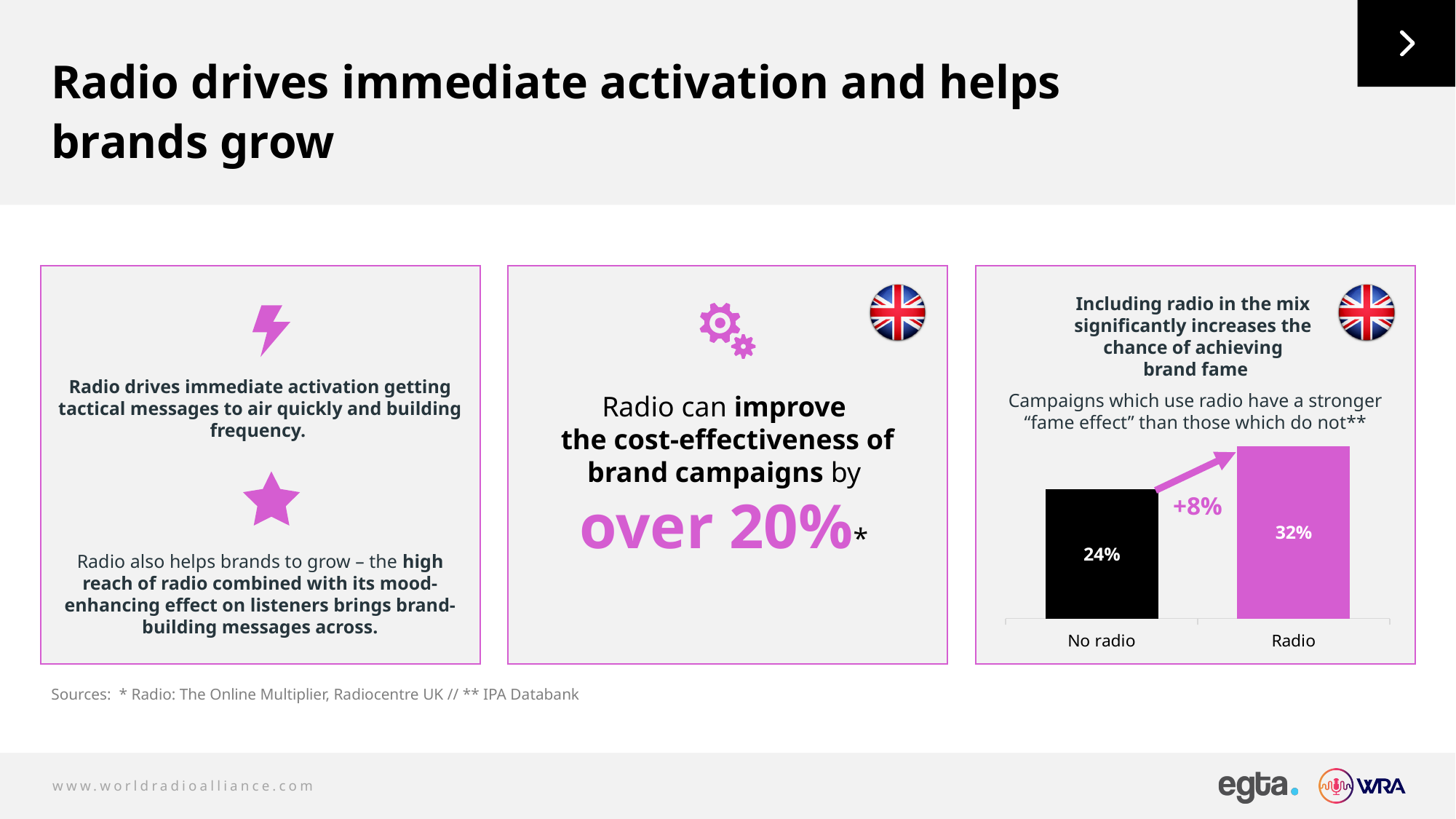
Which category has the higher value in the bar chart? Radio What is the value for No radio in the bar chart? 24% Do the values rise or fall from No radio to Radio? rise What kind of chart is shown on the right of the slide? bar chart What is the difference between the Radio and No radio values in the bar chart? 8% Is the value for Radio larger or smaller than the value for No radio? larger Which category has the lower value in the bar chart? No radio What is the value for Radio in the bar chart? 32% What colour is the Radio bar in the chart? pink What increase is labelled on the arrow between the two bars? +8% How many categories are shown in the bar chart? 2